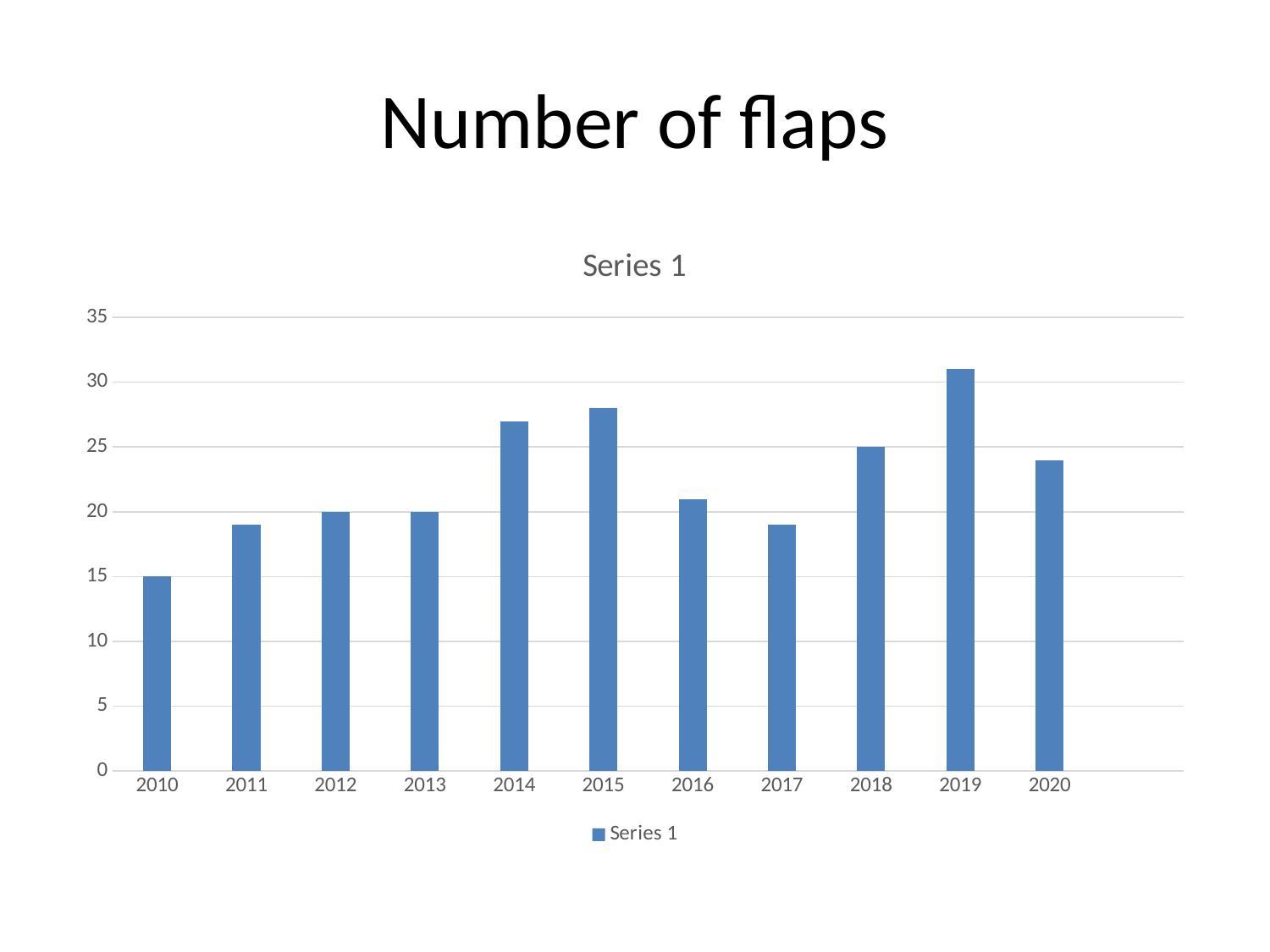
Which year has the highest number of flaps? 2019 Is the value for 2017 greater or less than 20? less Do the values rise or fall from 2010 to 2015? rise How many series does the legend list? 1 How many years are shown on the x axis of the chart? 11 What is the value for 2018? 25 Which year has the lowest number of flaps? 2010 What is the value for 2012? 20 Is the value for 2019 greater or less than 30? greater Which is larger, the value for 2015 or the value for 2016? 2015 What type of chart is shown on the slide? bar chart What is the value for 2010? 15